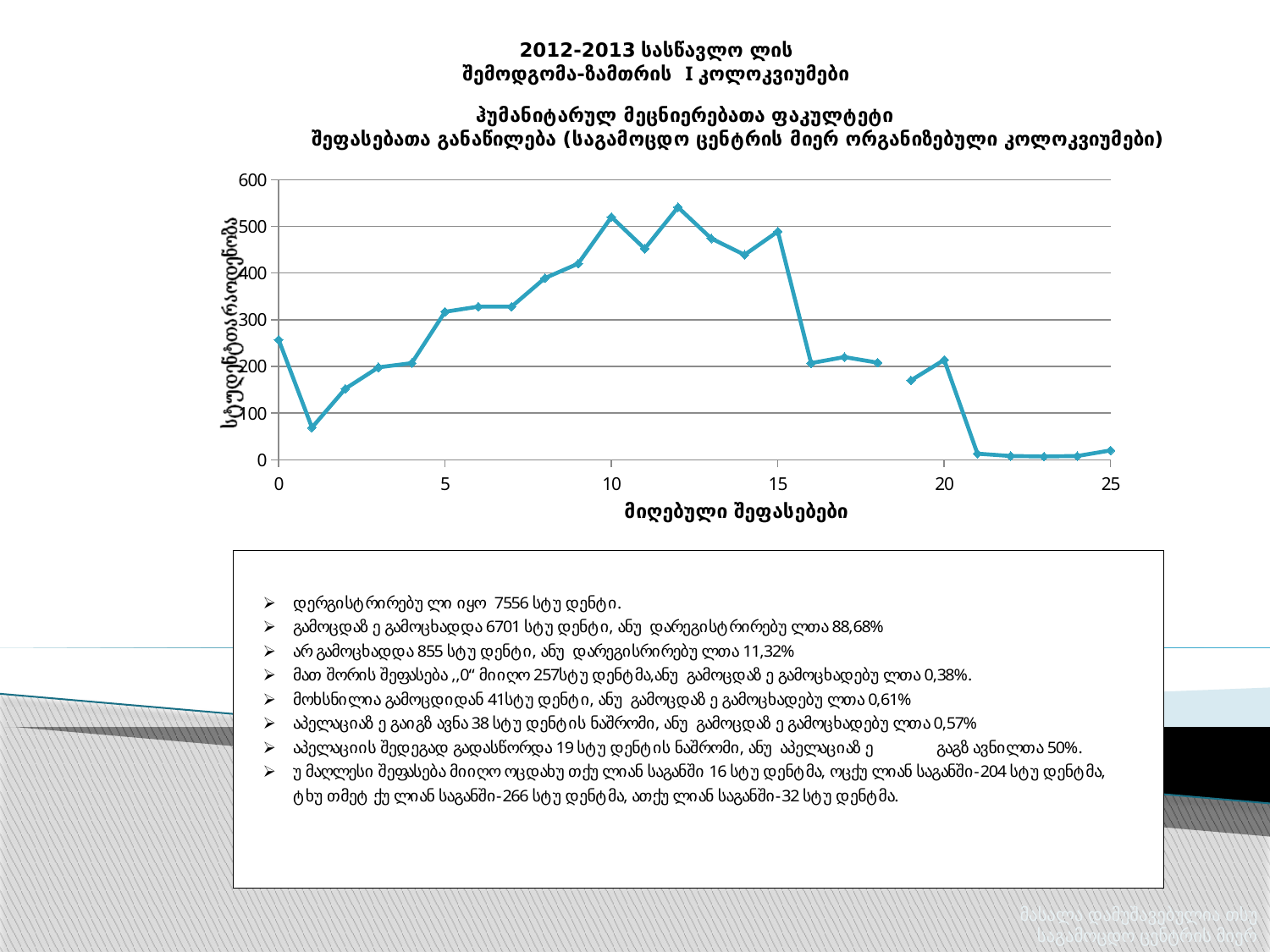
Is the value for score 5 greater or less than 300? greater Does the line rise or fall between score 1 and score 10? rise What kind of chart is shown on the slide? line chart Is the value for score 19 greater or less than 200? less At which score on the x axis does the line reach its highest value? 12 Is the value for score 0 greater or less than 200? greater Does the line rise or fall between score 20 and score 21? fall What is the title of the x axis of the chart? მიღებული შეფასებები Which has the larger value, score 10 or score 11? score 10